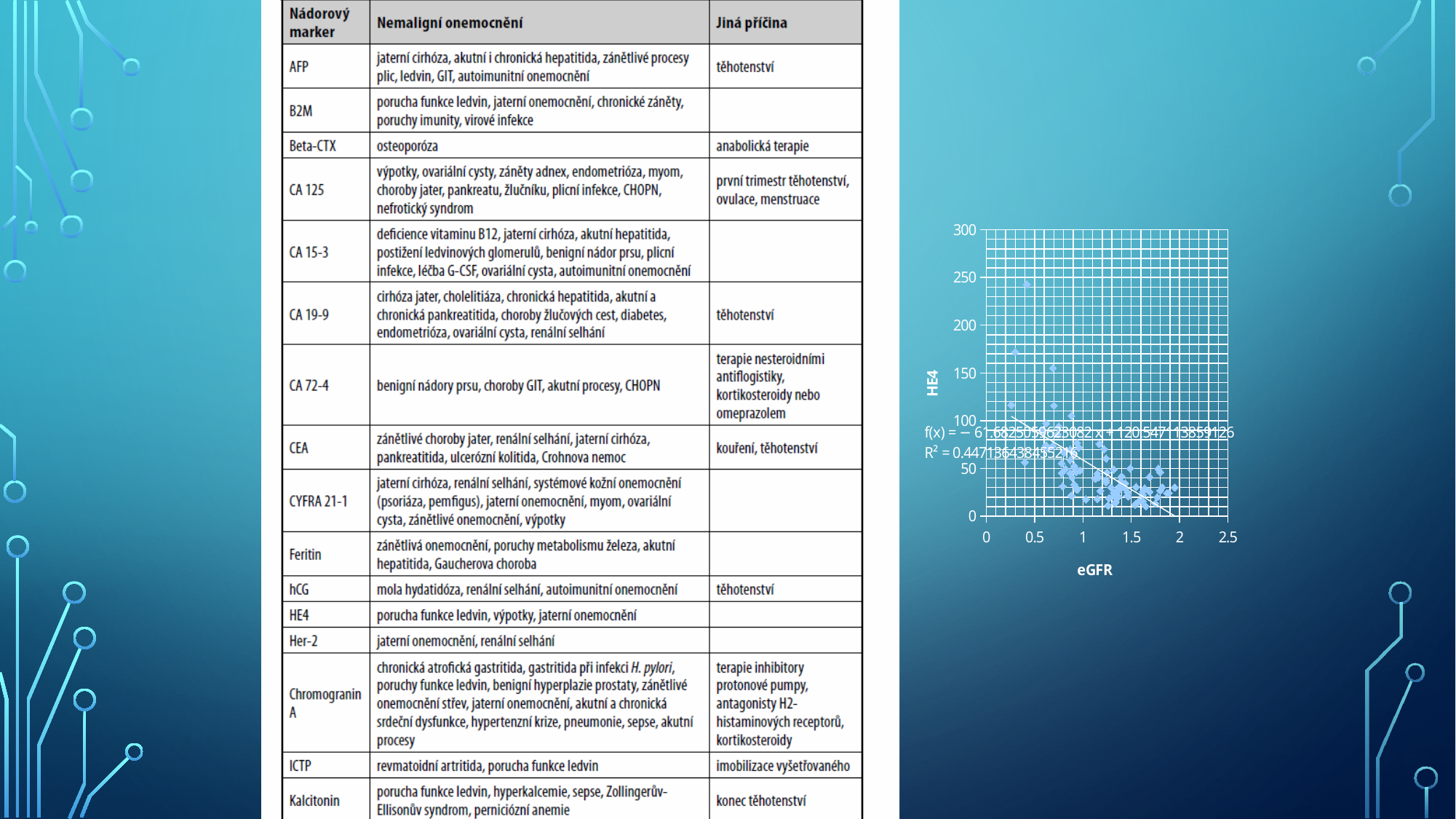
Is the HE4 value of the highest point in the scatter chart greater or less than 200? greater Are most of the points in the scatter chart above or below an HE4 value of 100? below What is the highest value shown on the y axis of the scatter chart? 300 What kind of chart is shown on the right side of the slide? scatter chart Does the fitted trendline in the scatter chart have a positive or negative slope? negative What is the label of the x axis of the scatter chart? eGFR In the scatter chart, do HE4 values generally rise or fall as eGFR increases? fall What is the label of the y axis of the scatter chart? HE4 What is the highest value shown on the x axis of the scatter chart? 2.5 Is the eGFR value of the highest HE4 point in the scatter chart greater or less than 1? less